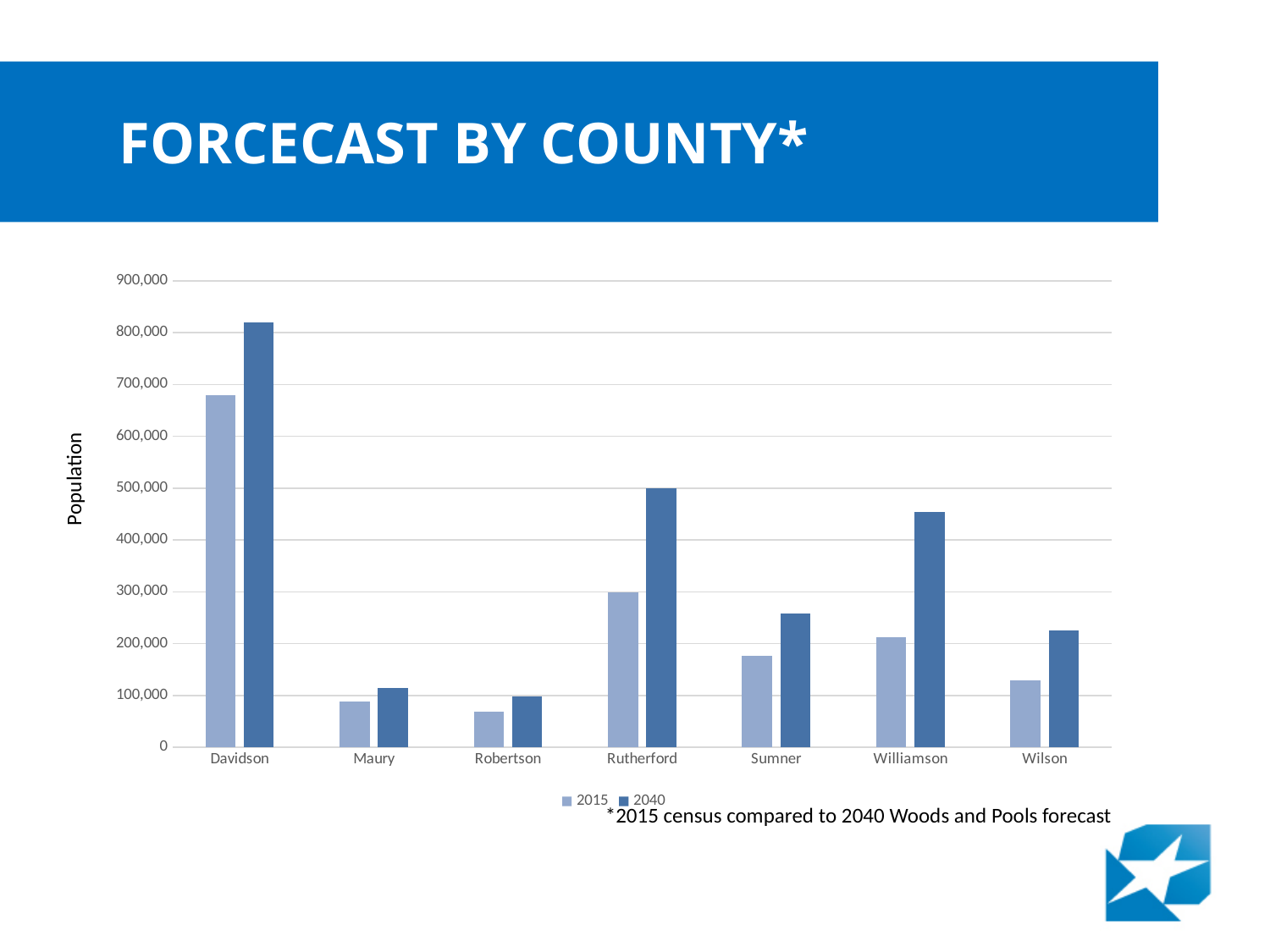
Which county has the lowest 2015 population? Robertson How many counties are shown on the x axis of the chart? 7 Is the 2040 value for Williamson greater or less than 400,000? greater Which county has the highest 2040 forecast population? Davidson What is the label on the vertical axis of the chart? Population Is the 2040 value for Davidson greater or less than 800,000? greater Which is larger: the 2015 value for Sumner or the 2015 value for Wilson? Sumner How many series does the chart legend list? 2 Which is larger: the 2040 value for Rutherford or the 2040 value for Williamson? Rutherford Which county has the lowest 2040 forecast population? Robertson What kind of chart is shown on the slide? bar chart Is the 2015 value for Maury greater or less than 100,000? less